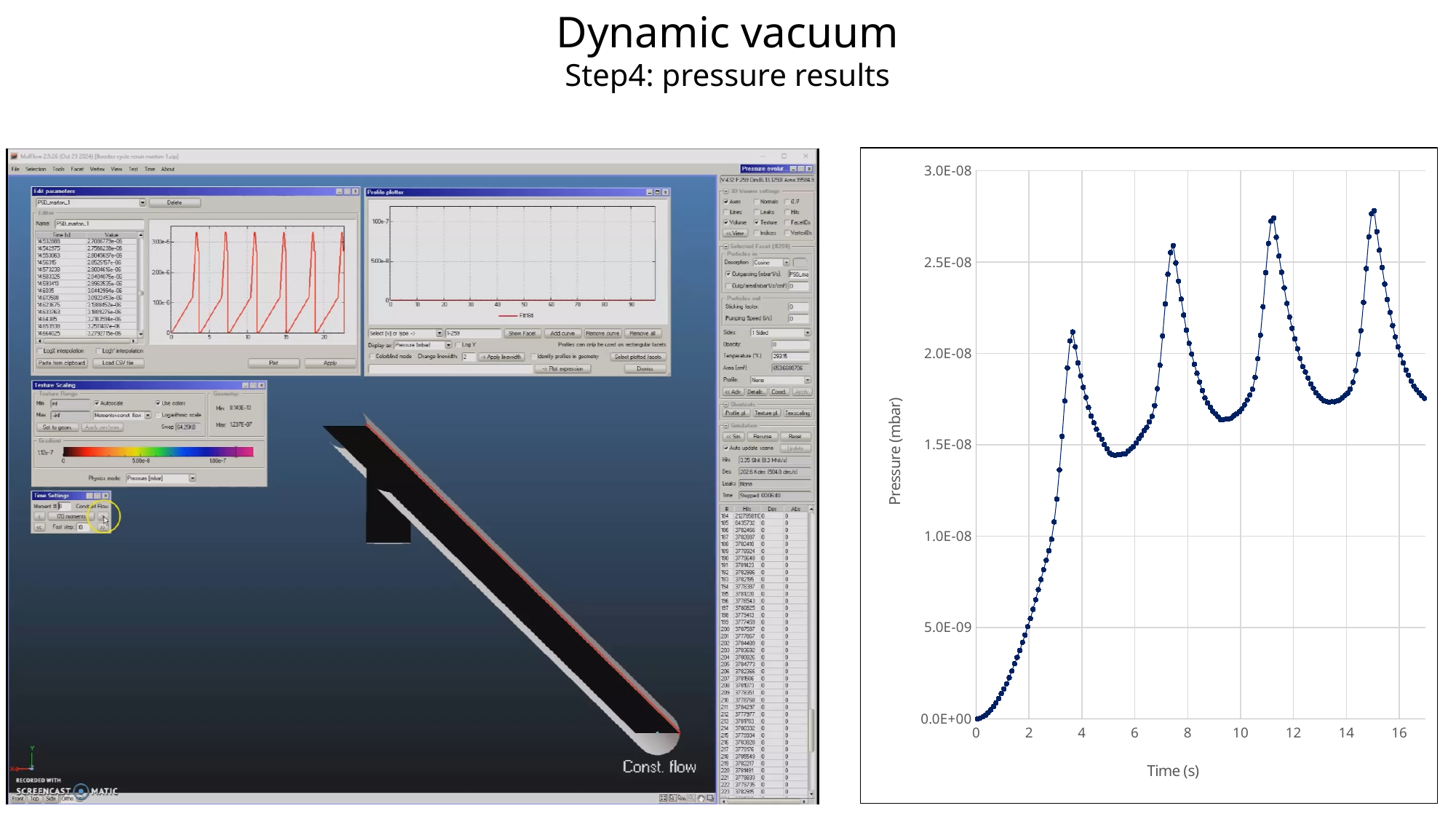
On the chart on the right, does the pressure rise or fall between time 0 and time 3 s? rise What kind of chart is shown on the right side of the slide? line chart On the chart on the right, is the highest pressure peak greater or less than 3.0E-08? less On the chart on the right, is the peak near time 15 s greater or less than 2.5E-08? greater On the chart on the right, is the pressure at time 10 s greater or less than 2.0E-08? less On the chart on the right, what is the pressure value at time 0? 0.0E+00 On the chart on the right, how many pressure peaks does the curve show? 4 What is the label of the x axis on the chart on the right? Time (s) On the chart on the right, which is higher: the first pressure peak (near 3.5 s) or the second pressure peak (near 7.5 s)? the second peak What is the label of the y axis on the chart on the right? Pressure (mbar)